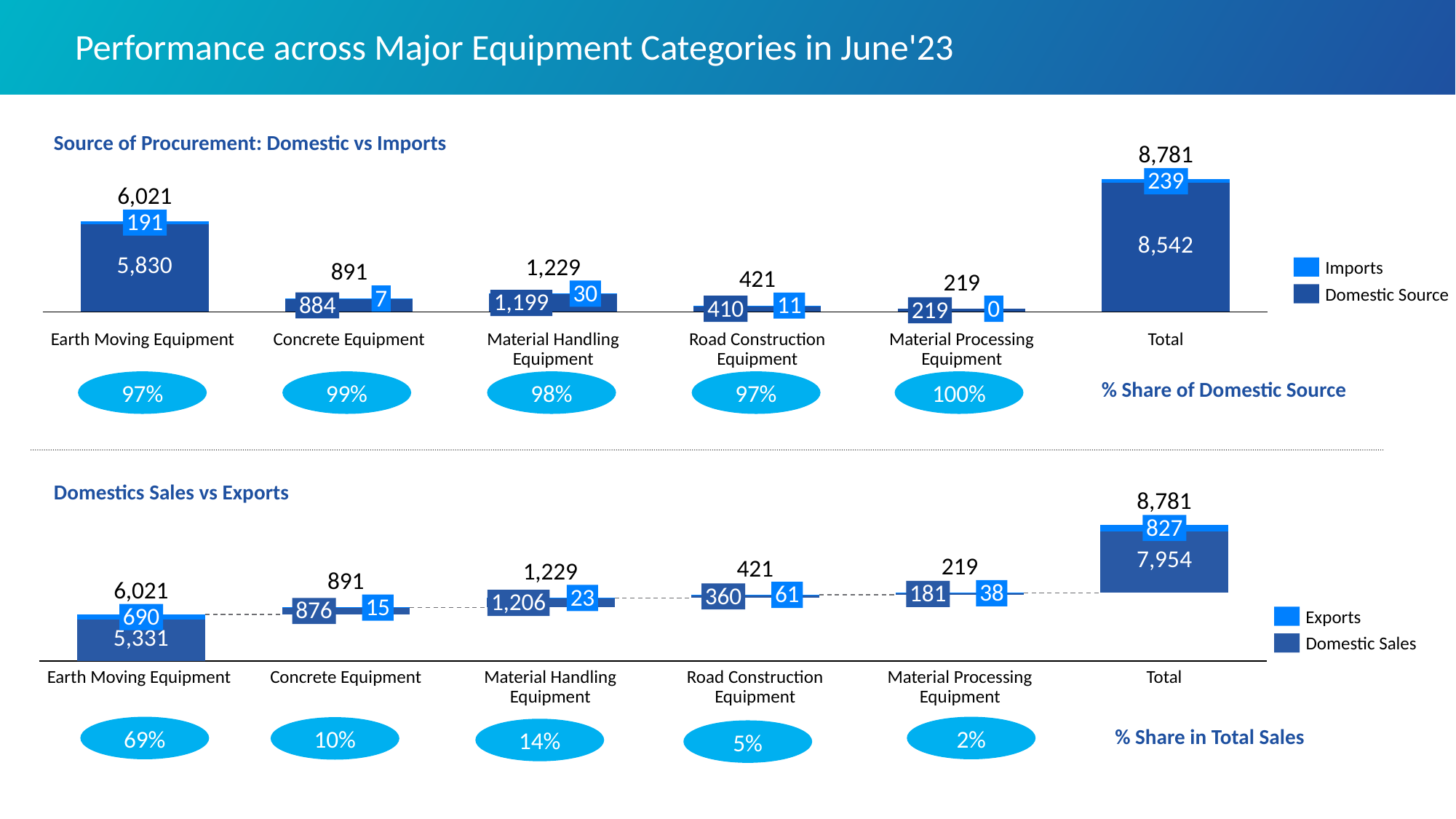
How many series does the legend of the 'Domestics Sales vs Exports' chart list? 2 In the 'Source of Procurement: Domestic vs Imports' chart, what is the total of the stacked bar for Concrete Equipment? 891 In the 'Domestics Sales vs Exports' chart, what is the difference between Domestic Sales and Exports for Material Processing Equipment? 143 In the 'Domestics Sales vs Exports' chart, which equipment category (excluding Total) has the highest Exports value? Earth Moving Equipment What kind of chart is the 'Source of Procurement: Domestic vs Imports' chart? Stacked bar chart In the 'Source of Procurement: Domestic vs Imports' chart, what is the difference between the Imports values for Total and Earth Moving Equipment? 48 In the 'Domestics Sales vs Exports' chart, is the Domestic Sales value larger for Concrete Equipment or for Material Handling Equipment? Material Handling Equipment In the 'Source of Procurement: Domestic vs Imports' chart, what is the Imports value for Material Handling Equipment? 30 In the 'Source of Procurement: Domestic vs Imports' chart, what is the Domestic Source value for Earth Moving Equipment? 5,830 In the 'Domestics Sales vs Exports' chart, what is the Exports value for Road Construction Equipment? 61 In the 'Source of Procurement: Domestic vs Imports' chart, which equipment category (excluding Total) has the lowest stacked bar total? Material Processing Equipment In the 'Domestics Sales vs Exports' chart, what is the Domestic Sales value for Total? 7,954